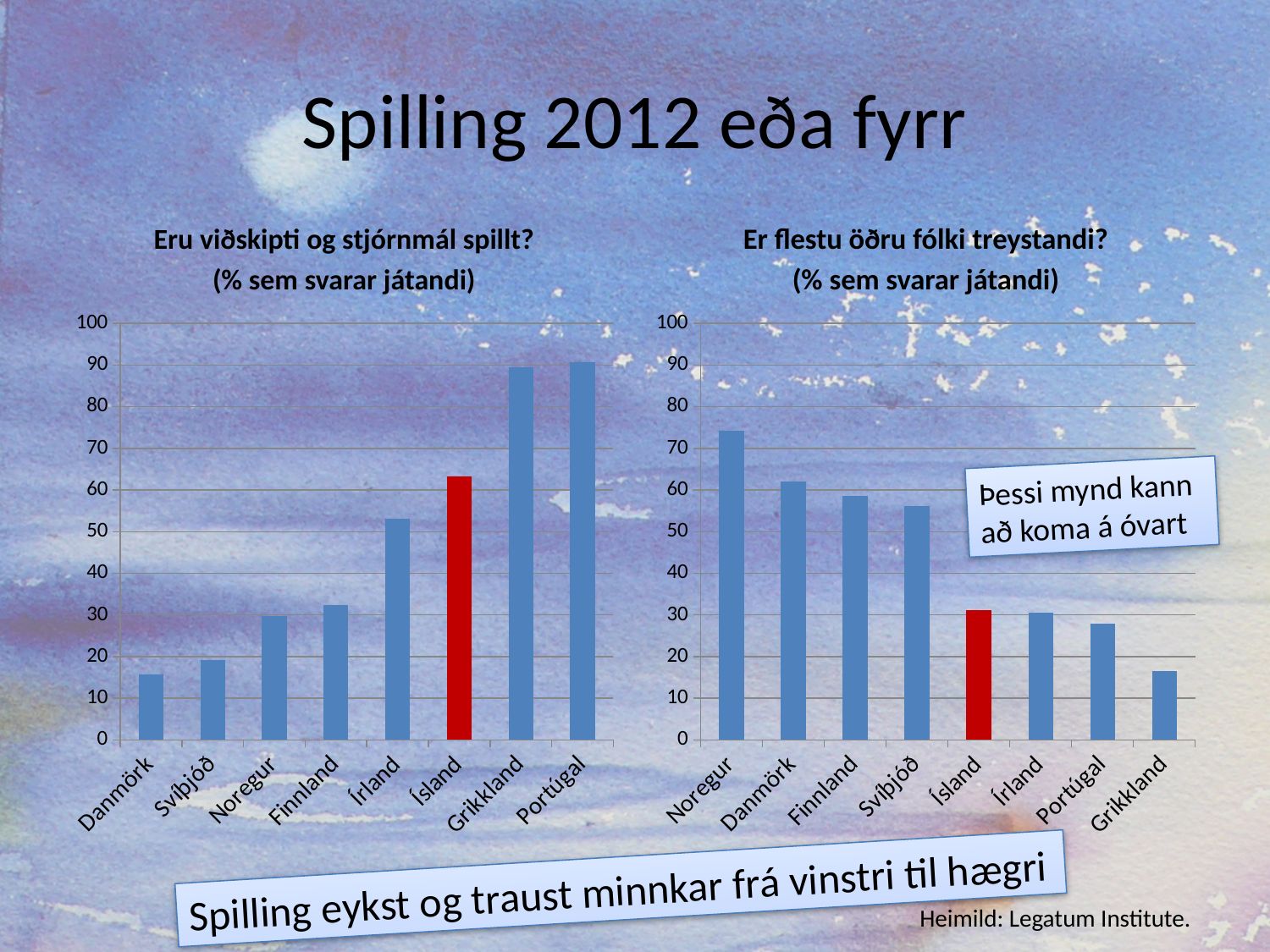
On the left chart, 'Eru viðskipti og stjórnmál spillt?', do the values generally rise or fall from left to right? rise How many countries are shown on the left chart, 'Eru viðskipti og stjórnmál spillt?'? 8 On the right chart, 'Er flestu öðru fólki treystandi?', do the values generally rise or fall from left to right? fall On the left chart, 'Eru viðskipti og stjórnmál spillt?', is the value for Grikkland greater or less than 80? greater On the left chart, 'Eru viðskipti og stjórnmál spillt?', is the value for Ísland greater or less than 50? greater On the right chart, 'Er flestu öðru fólki treystandi?', which country has the highest value? Noregur What kind of chart is the left chart, 'Eru viðskipti og stjórnmál spillt?'? bar chart On the right chart, 'Er flestu öðru fólki treystandi?', which country's bar is coloured red? Ísland On the left chart, 'Eru viðskipti og stjórnmál spillt?', which country has the lowest value? Danmörk On the right chart, 'Er flestu öðru fólki treystandi?', is the value for Ísland greater or less than 40? less On the right chart, 'Er flestu öðru fólki treystandi?', which country has the lowest value? Grikkland On the left chart, 'Eru viðskipti og stjórnmál spillt?', which is larger, the value for Ísland or the value for Írland? Ísland